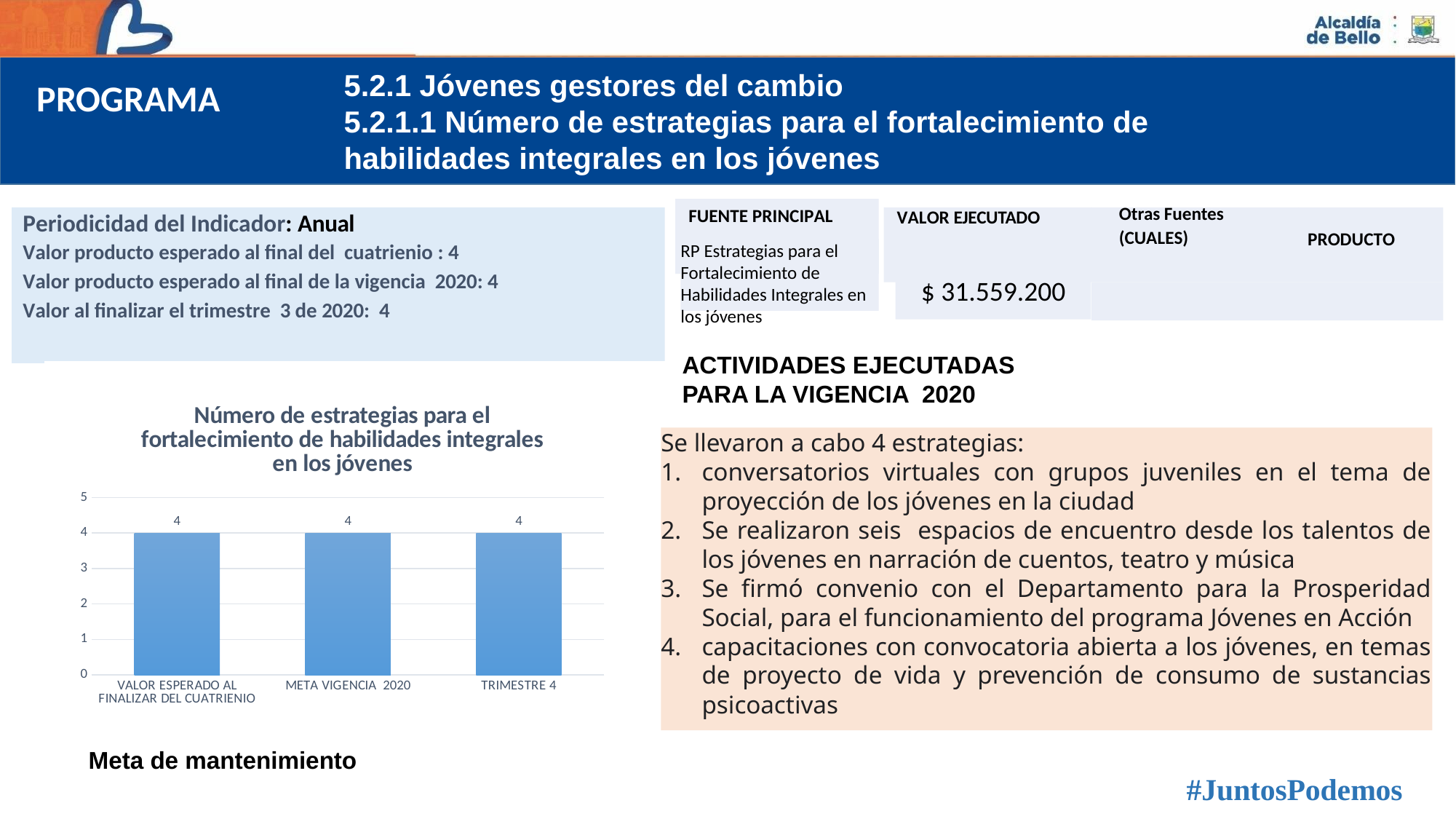
What is the highest value shown on the chart's vertical axis? 5 What is the difference between the values for META VIGENCIA 2020 and TRIMESTRE 4? 0 What is the title of the chart? Número de estrategias para el fortalecimiento de habilidades integrales en los jóvenes Do the values rise, fall, or stay the same across the categories from left to right? stay the same What is the value for TRIMESTRE 4? 4 What is the value for META VIGENCIA 2020? 4 Is the value for TRIMESTRE 4 greater or less than 3? greater Is the value for META VIGENCIA 2020 greater or less than 5? less How many categories are shown on the x axis of the chart? 3 What is the value for VALOR ESPERADO AL FINALIZAR DEL CUATRIENIO? 4 What kind of chart is shown on the slide? bar chart